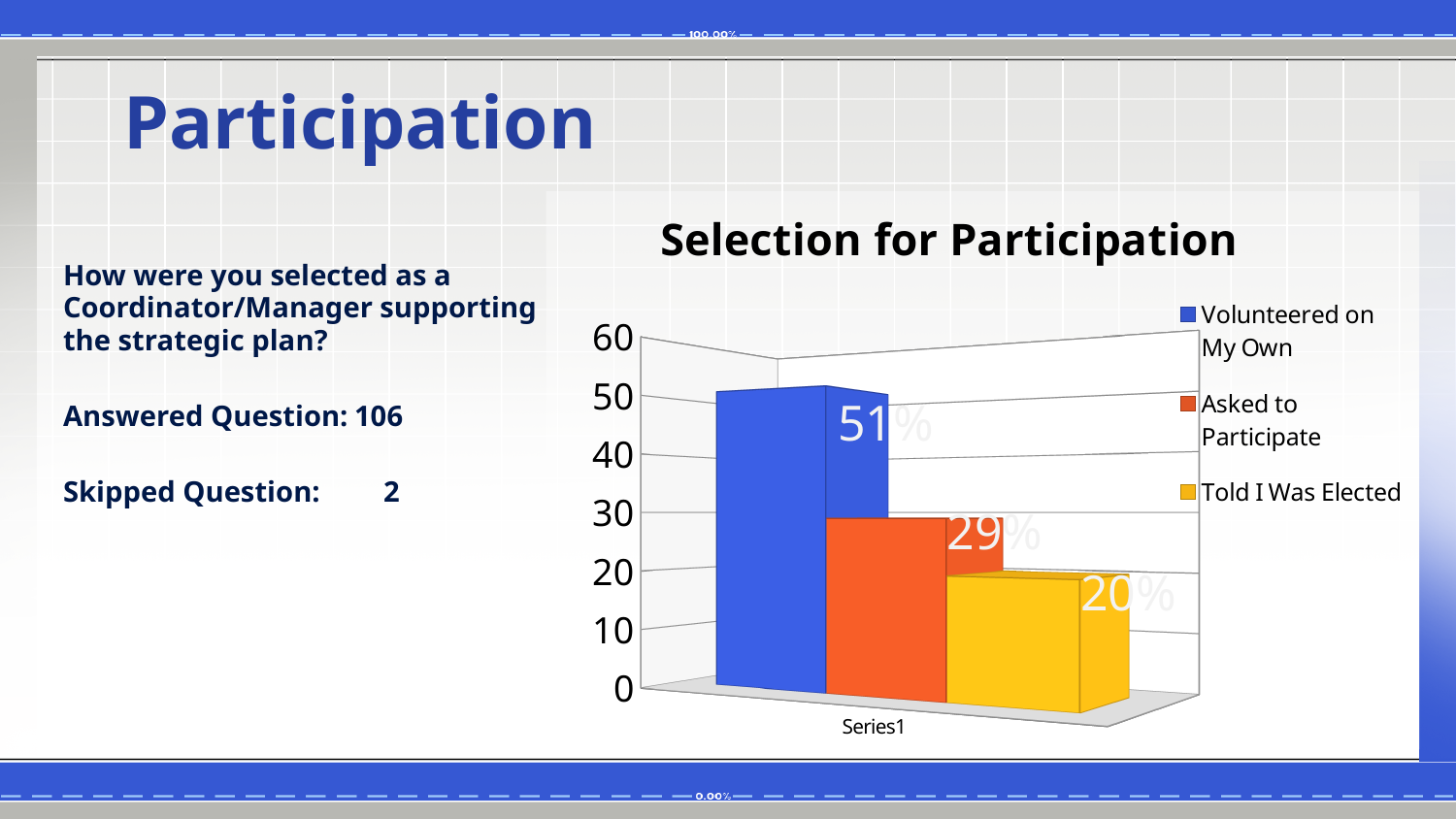
How many series does the legend of the Selection for Participation chart list? 3 Which series has the highest value in the Selection for Participation chart? Volunteered on My Own Which series has the lowest value in the Selection for Participation chart? Told I Was Elected Which is larger, the value for Asked to Participate or the value for Told I Was Elected? Asked to Participate What is the difference between the values for Volunteered on My Own and Asked to Participate? 22% What is the difference between the values for Asked to Participate and Told I Was Elected? 9% What is the value for Volunteered on My Own in the Selection for Participation chart? 51% What is the value for Told I Was Elected in the Selection for Participation chart? 20% Is the value for Volunteered on My Own greater or less than 40? greater What is the title of the chart on the slide? Selection for Participation What kind of chart is the Selection for Participation chart? bar chart What is the value for Asked to Participate in the Selection for Participation chart? 29%